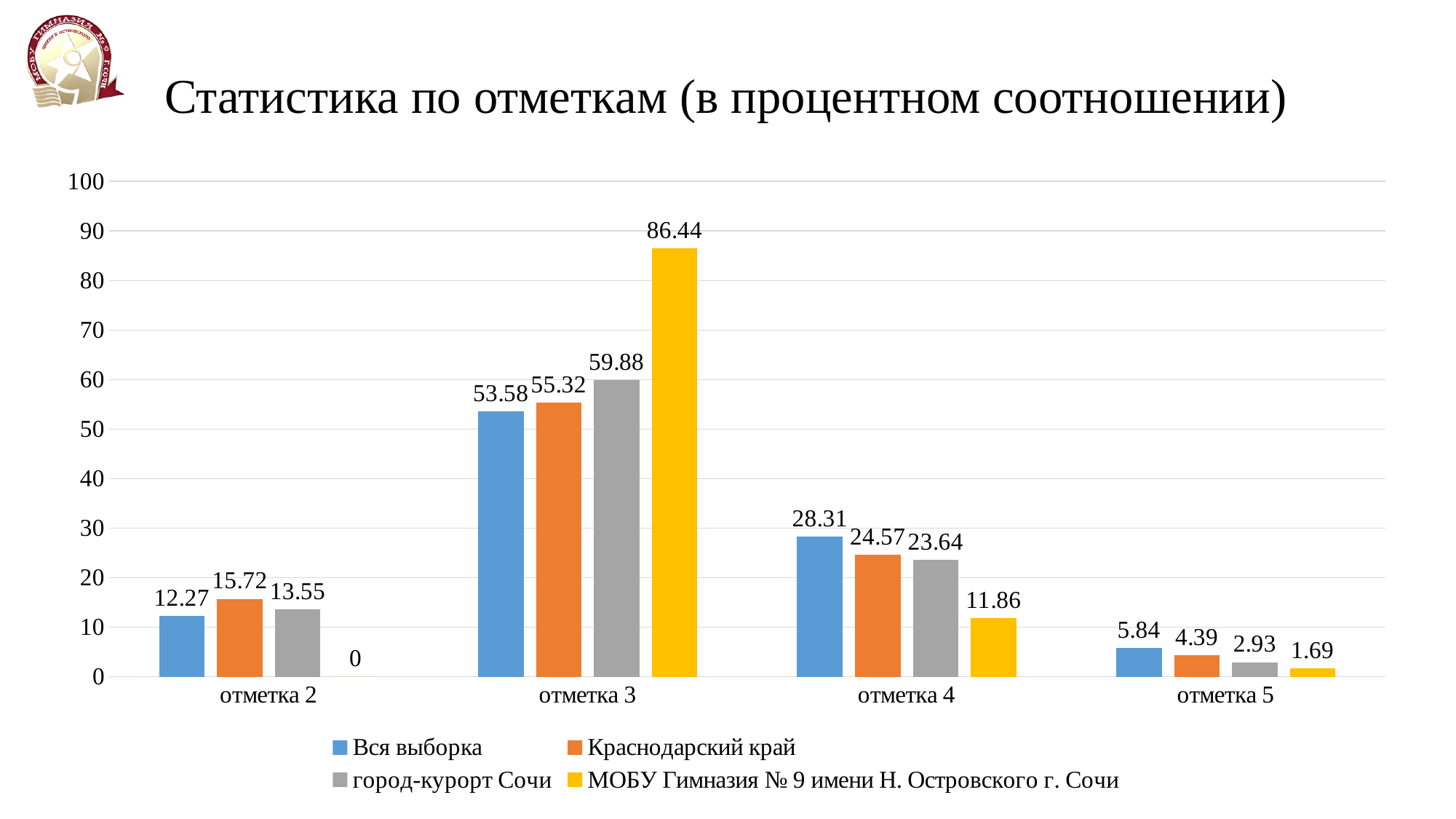
What is the value for город-курорт Сочи at отметка 5? 2.93 Which category has the lowest value for the Вся выборка series? отметка 5 Which category has the highest value for the МОБУ Гимназия № 9 имени Н. Островского г. Сочи series? отметка 3 What is the title of the chart on the slide? Статистика по отметкам (в процентном соотношении) What is the difference between the город-курорт Сочи and Вся выборка values at отметка 3? 6.30 How many series does the legend list? 4 At отметка 4, which is larger: Краснодарский край or МОБУ Гимназия № 9 имени Н. Островского г. Сочи? Краснодарский край What kind of chart is shown on the slide? bar chart What is the value for Краснодарский край at отметка 2? 15.72 What is the value for Вся выборка at отметка 4? 28.31 How many categories are shown on the x axis? 4 What is the value for МОБУ Гимназия № 9 имени Н. Островского г. Сочи at отметка 3? 86.44